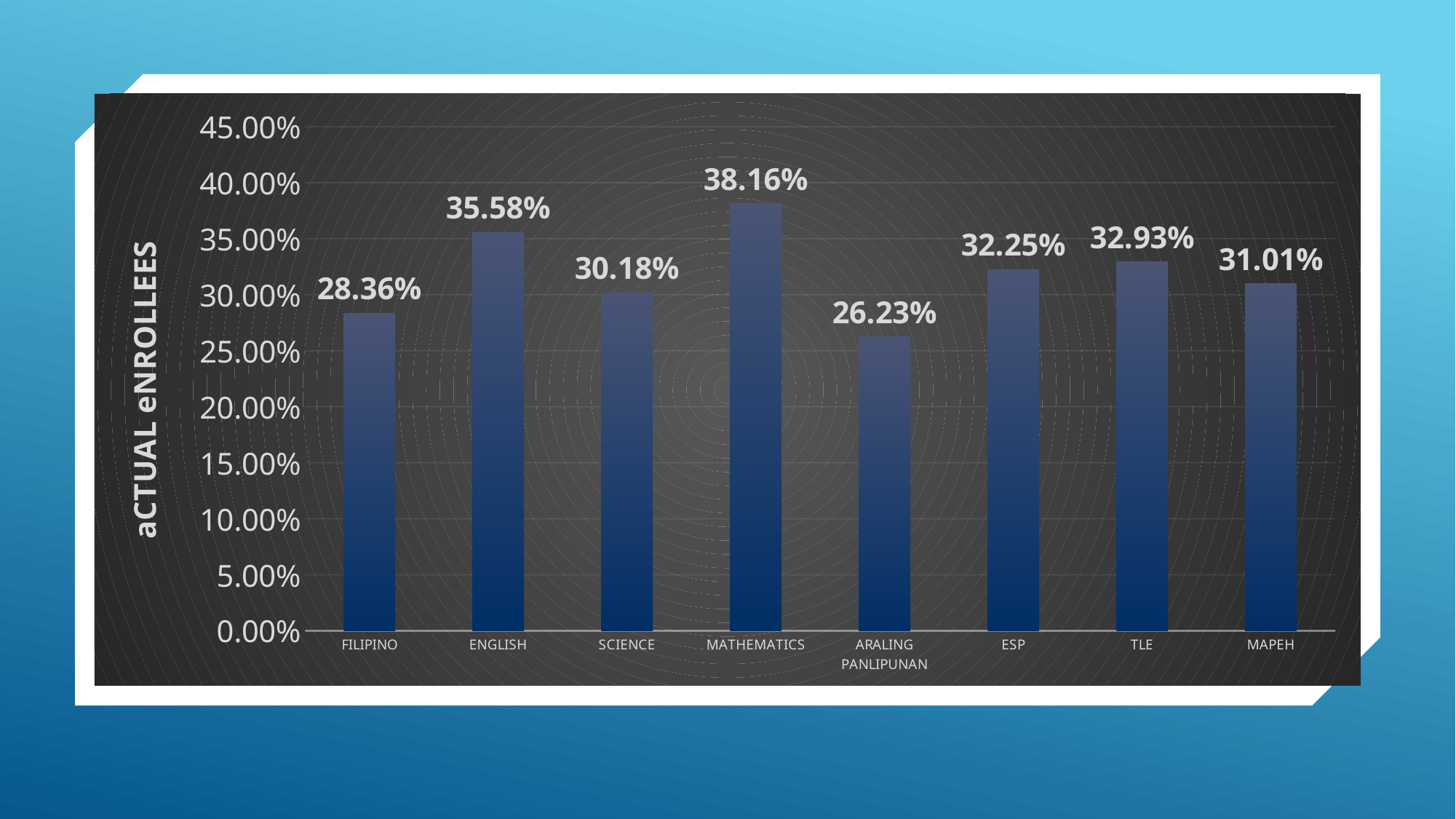
What is the difference between the values for ENGLISH and FILIPINO? 7.22% What kind of chart is shown on the slide? bar chart How many categories are shown on the x axis? 8 Which category has the highest value? MATHEMATICS What is the value for TLE? 32.93% Which is larger, the value for ESP or the value for SCIENCE? ESP What is the value for ARALING PANLIPUNAN? 26.23% What is the difference between the values for MATHEMATICS and ARALING PANLIPUNAN? 11.93% What is the label of the vertical axis? aCTUAL eNROLLEES Which category has the lowest value? ARALING PANLIPUNAN What is the value for MATHEMATICS? 38.16% Is the value for MAPEH greater or less than 30.00%? greater